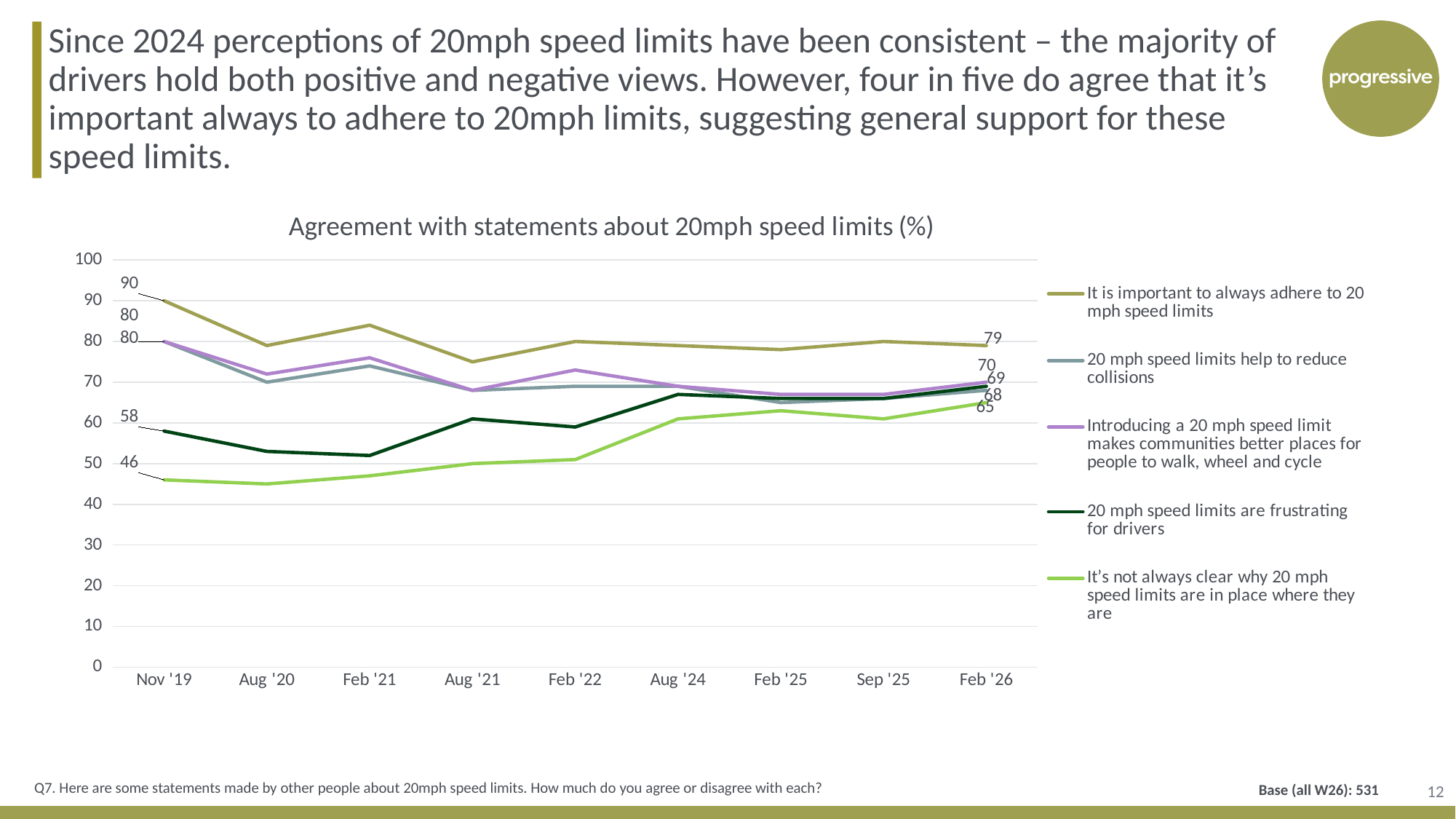
Is the value for '20 mph speed limits are frustrating for drivers' at Aug '24 greater or less than 60? greater How many time points are shown on the x axis? 9 By how much did agreement with 'It is important to always adhere to 20 mph speed limits' fall between Nov '19 and Feb '26? 11 Which statement had the highest agreement at Nov '19? It is important to always adhere to 20 mph speed limits Which statement had the lowest agreement at Nov '19? It's not always clear why 20 mph speed limits are in place where they are What is the value for 'It's not always clear why 20 mph speed limits are in place where they are' at Nov '19? 46 What is the value for 'It is important to always adhere to 20 mph speed limits' at Feb '26? 79 What is the value for 'It is important to always adhere to 20 mph speed limits' at Nov '19? 90 What is the value for 'It's not always clear why 20 mph speed limits are in place where they are' at Feb '26? 65 What kind of chart is shown on the slide? line chart How many series does the legend list? 5 What is the value for '20 mph speed limits are frustrating for drivers' at Nov '19? 58